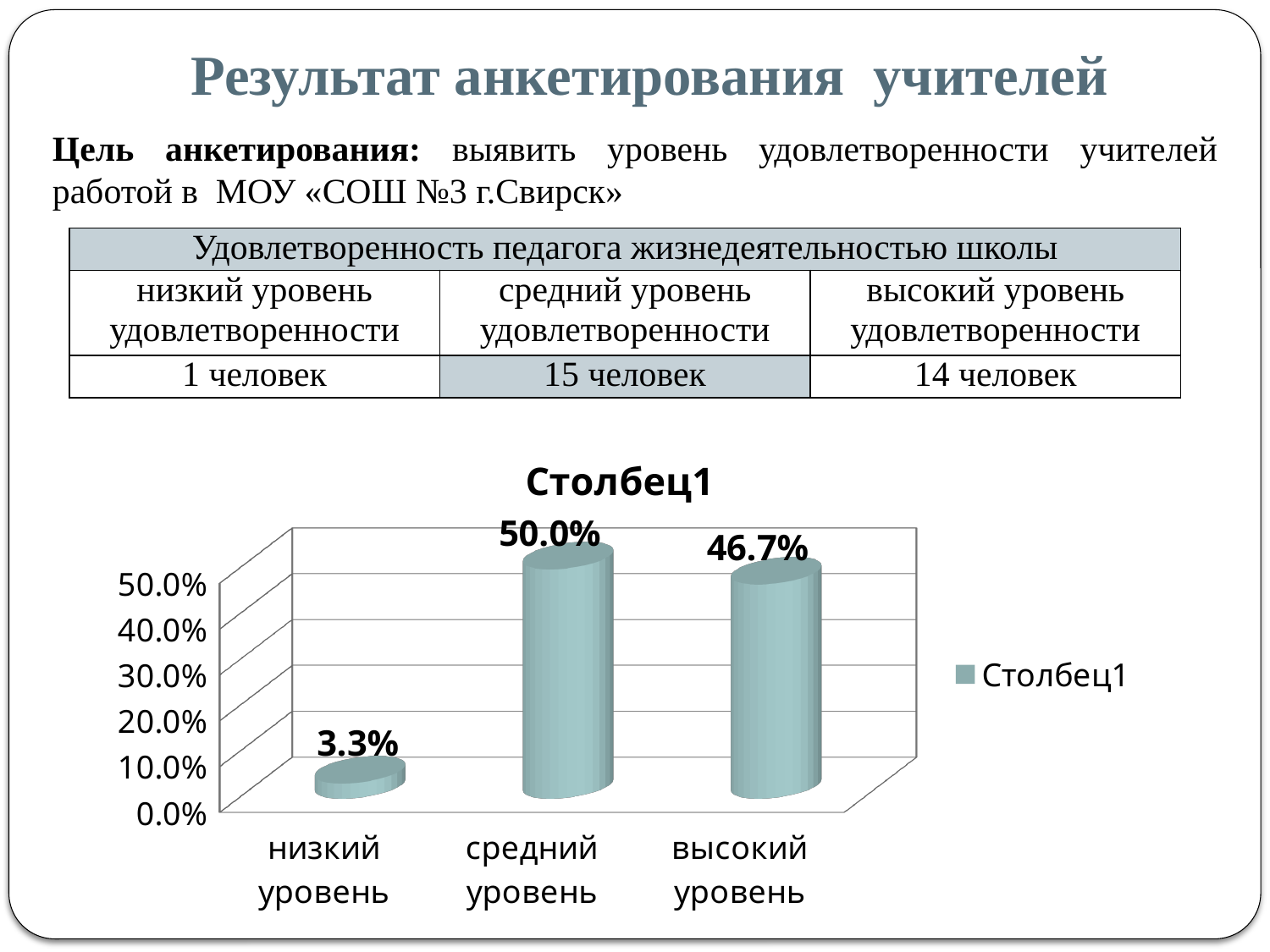
Which category has the highest value? средний уровень Which is larger, the value for низкий уровень or the value for высокий уровень? высокий уровень What kind of chart is shown on the slide? bar chart How many categories are shown on the x axis? 3 What is the value for средний уровень? 50.0% Is the value for высокий уровень greater or less than 40.0%? greater What is the difference between the values for высокий уровень and низкий уровень? 43.4% Which category has the lowest value? низкий уровень What is the title of the chart? Столбец1 What is the value for низкий уровень? 3.3% What is the value for высокий уровень? 46.7% What is the difference between the values for средний уровень and высокий уровень? 3.3%